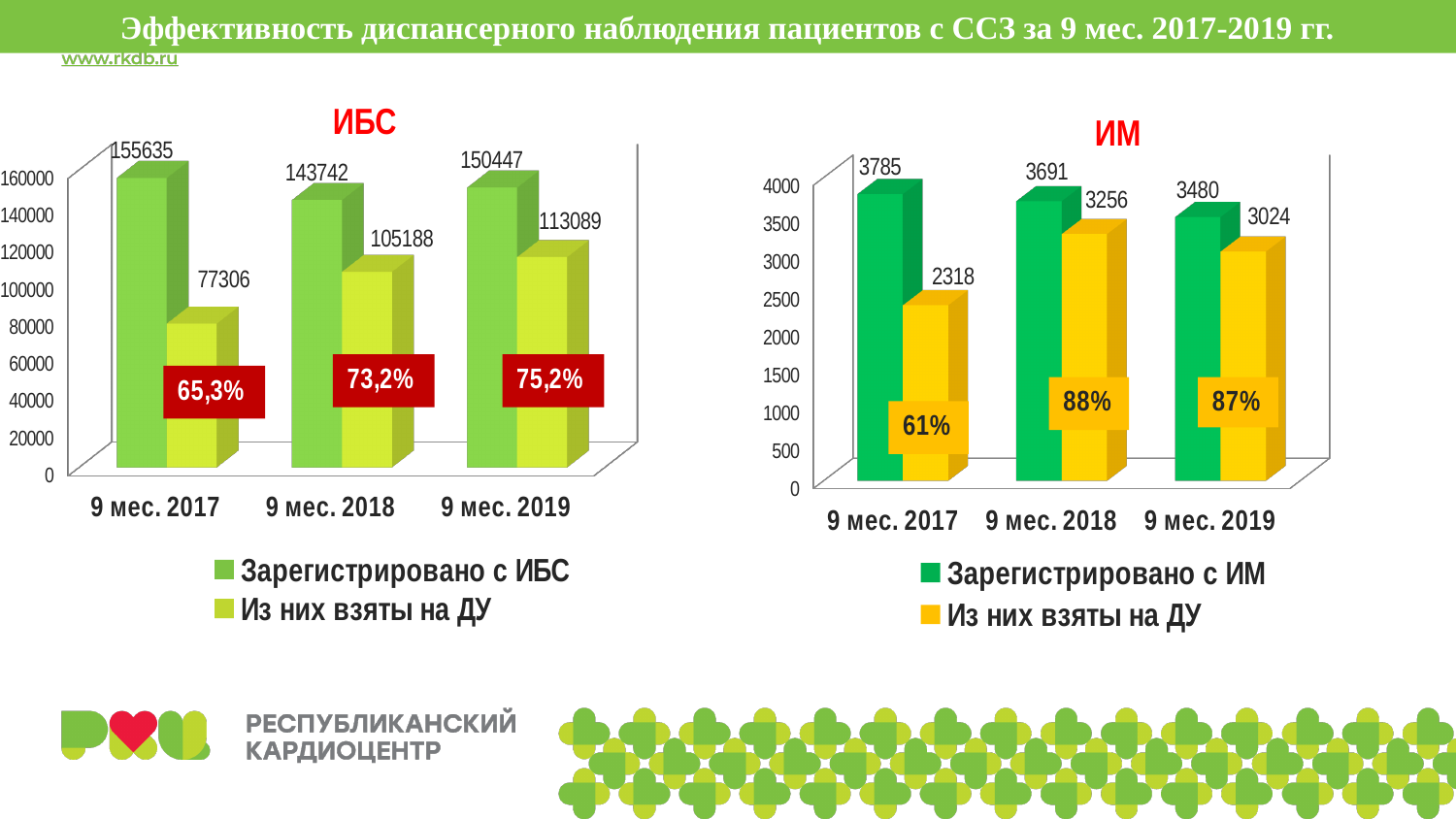
In the ИБС chart, which period has the lowest value of Из них взяты на ДУ? 9 мес. 2017 In the ИМ chart, which period has the highest value of Зарегистрировано с ИМ? 9 мес. 2017 In the ИМ chart, what is the difference between Из них взяты на ДУ for 9 мес. 2018 and 9 мес. 2019? 232 In the ИБС chart, what is the value of Зарегистрировано с ИБС for 9 мес. 2017? 155635 In the ИМ chart, is Зарегистрировано с ИМ for 9 мес. 2019 larger or smaller than for 9 мес. 2018? smaller In the ИБС chart, does the value of Из них взяты на ДУ rise or fall from 9 мес. 2017 to 9 мес. 2019? rise In the ИМ chart, what is the value of Из них взяты на ДУ for 9 мес. 2017? 2318 In the ИМ chart, what is the value of Зарегистрировано с ИМ for 9 мес. 2018? 3691 In the ИБС chart, what is the difference between Зарегистрировано с ИБС and Из них взяты на ДУ for 9 мес. 2018? 38554 What type of chart is the ИБС chart? bar chart How many series does the legend of the ИМ chart list? 2 In the ИБС chart, what is the value of Из них взяты на ДУ for 9 мес. 2019? 113089